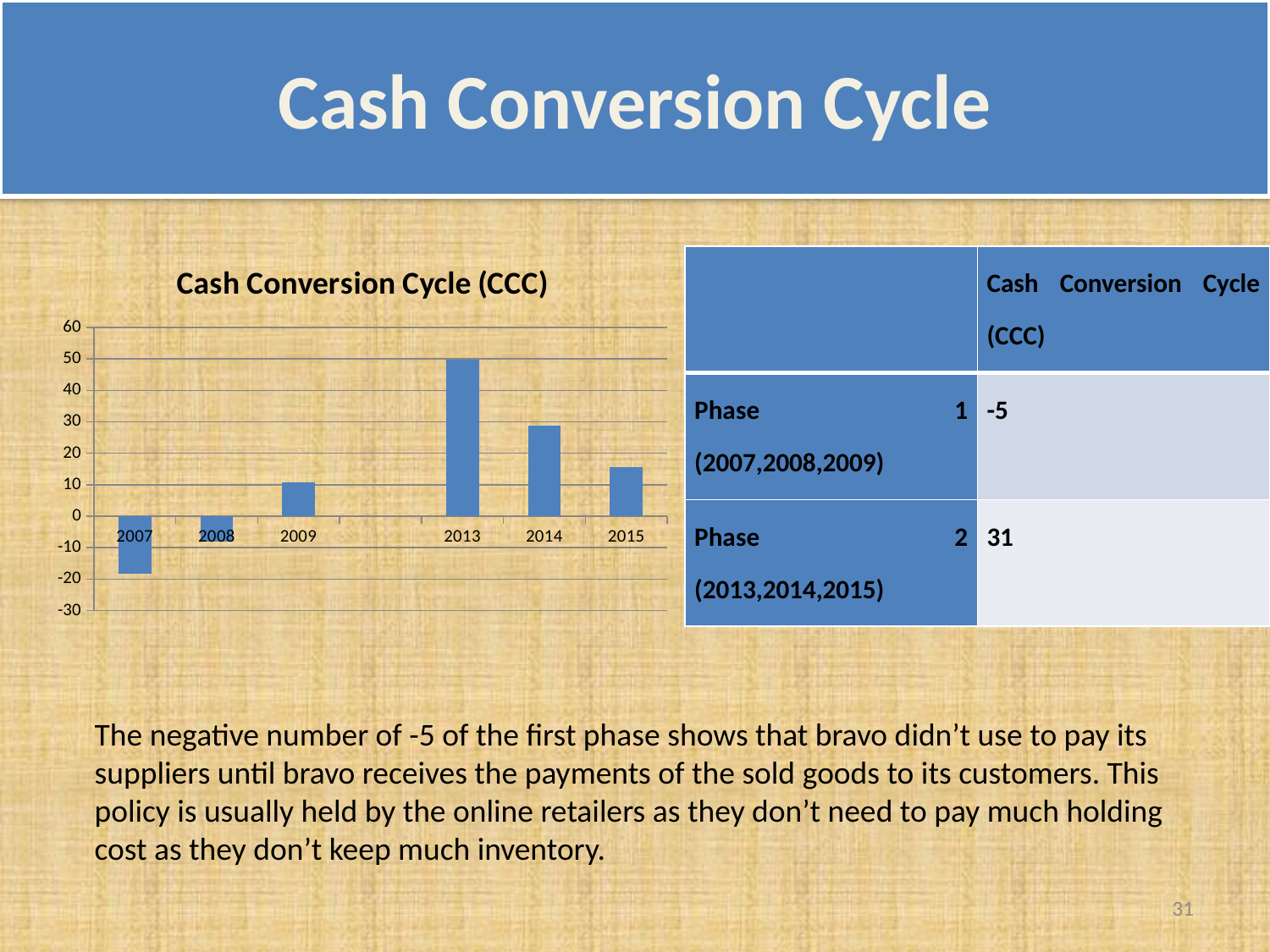
Is the value for 2014 greater or less than 20? greater What is the title of the chart? Cash Conversion Cycle (CCC) Do the values rise or fall from 2013 to 2015? fall Which year has the lowest value on the chart? 2007 Which year has the larger value, 2009 or 2008? 2009 Is the value for 2008 greater or less than 0? less How many years are plotted on the chart? 6 Is the value for 2013 greater or less than 40? greater Which year has the larger value, 2014 or 2015? 2014 What kind of chart is shown on the slide? bar chart Which year has the highest value on the chart? 2013